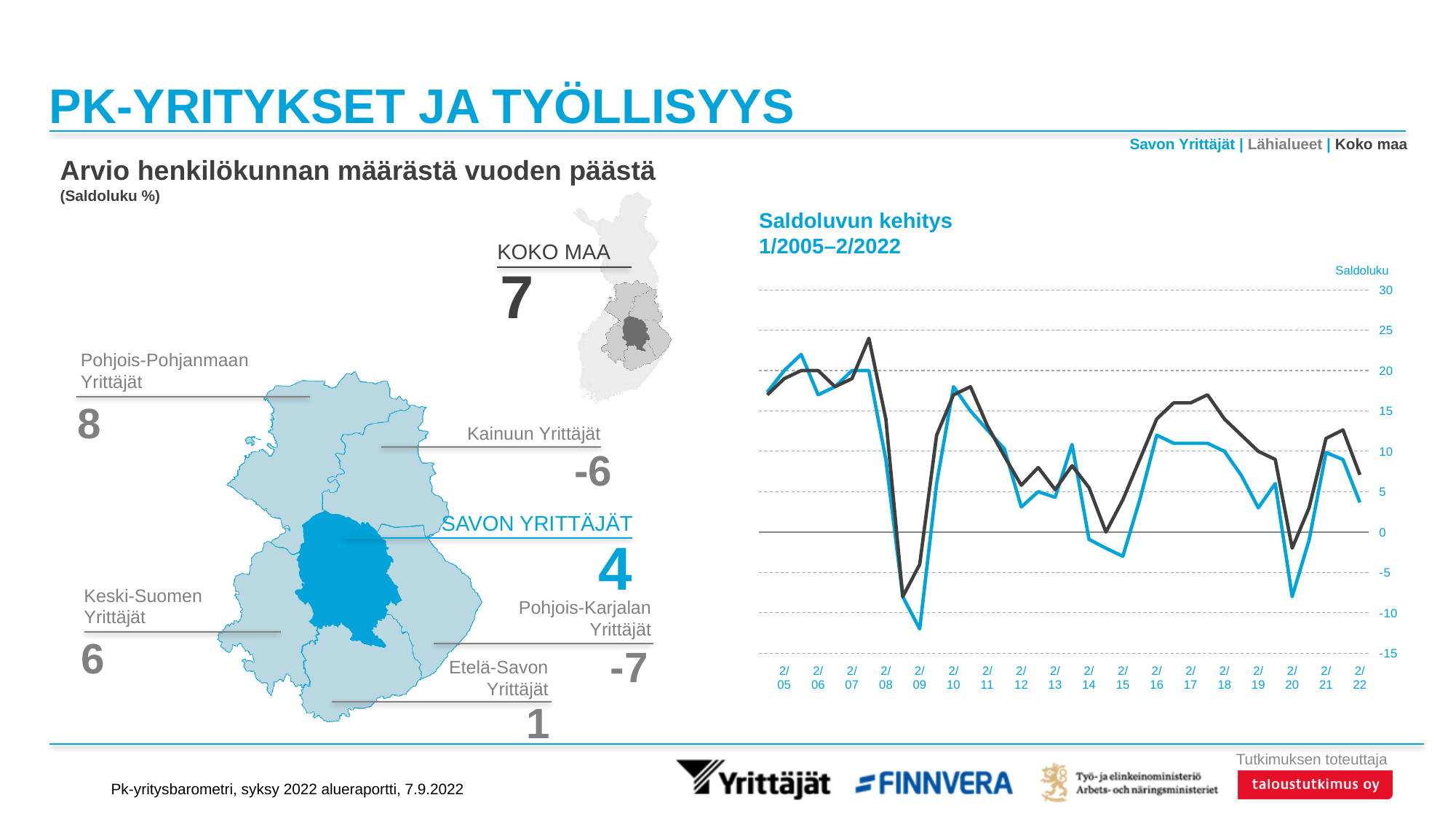
In the map figure 'Arvio henkilökunnan määrästä vuoden päästä', what is the saldoluku for Savon Yrittäjät? 4 In the chart 'Saldoluvun kehitys 1/2005–2/2022', how many time points are labelled on the x axis? 18 What kind of chart is 'Saldoluvun kehitys 1/2005–2/2022'? line chart In the chart 'Saldoluvun kehitys 1/2005–2/2022', do the lines rise or fall from 2/21 to 2/22? fall In the map figure, which is larger: the value for Keski-Suomen Yrittäjät or Etelä-Savon Yrittäjät? Keski-Suomen Yrittäjät In the map figure, what is the value shown for Koko maa? 7 In the map figure, what is the value for Pohjois-Karjalan Yrittäjät? -7 In the map figure, which region has the highest saldoluku? Pohjois-Pohjanmaan Yrittäjät In the chart 'Saldoluvun kehitys 1/2005–2/2022', is the Savon Yrittäjät (blue) value at 2/09 greater or less than -10? less In the map figure, which region has the lowest saldoluku? Pohjois-Karjalan Yrittäjät In the map figure, what is the difference between the values for Pohjois-Pohjanmaan Yrittäjät and Kainuun Yrittäjät? 14